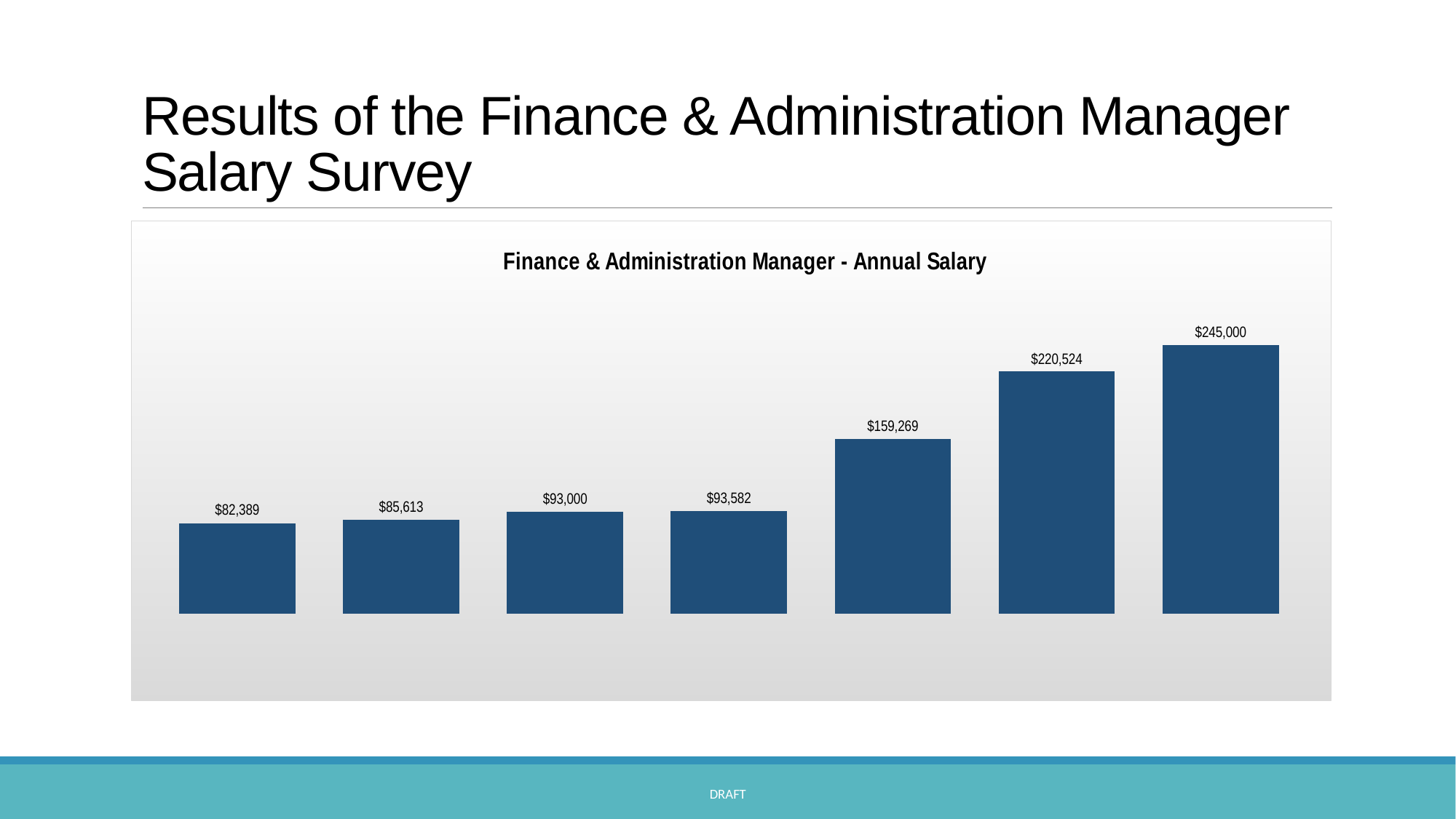
What is the difference between the highest and lowest values shown in the chart? $162,611 What is the value shown on the rightmost bar? $245,000 What is the value shown on the fifth bar from the left? $159,269 What is the highest value shown in the chart? $245,000 Do the bar values rise or fall from left to right across the chart? rise What is the value shown on the third bar from the left? $93,000 What kind of chart is shown on the slide? bar chart How many bars are plotted in the chart? 7 What is the value shown on the leftmost bar? $82,389 What is the title of the chart? Finance & Administration Manager - Annual Salary Which is larger, the value on the sixth bar or the value on the fifth bar? the sixth bar ($220,524) What is the lowest value shown in the chart? $82,389